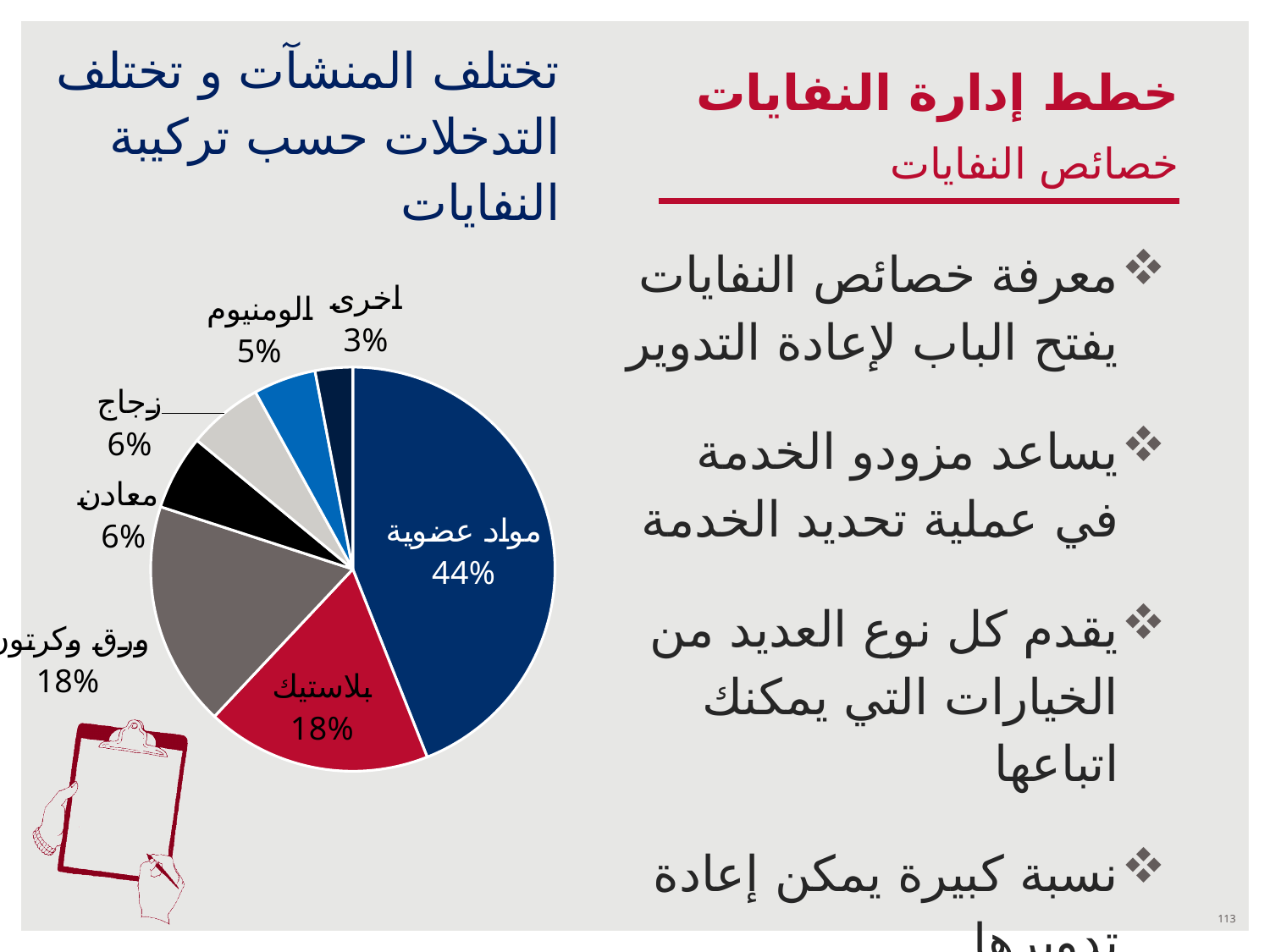
What share of the pie does مواد عضوية represent? 44% What is the value shown for بلاستيك? 18% What is the value shown for اخرى? 3% How many slices does the pie chart have? 7 What is the value shown for زجاج? 6% What kind of chart is shown on the slide? pie chart Which category has the smallest slice of the pie? اخرى Which is larger, the value for الومنيوم or the value for معادن? معادن What is the value shown for الومنيوم? 5% Which category has the largest slice of the pie? مواد عضوية What is the difference between the values for مواد عضوية and بلاستيك? 26% What colour is the slice for مواد عضوية? dark blue